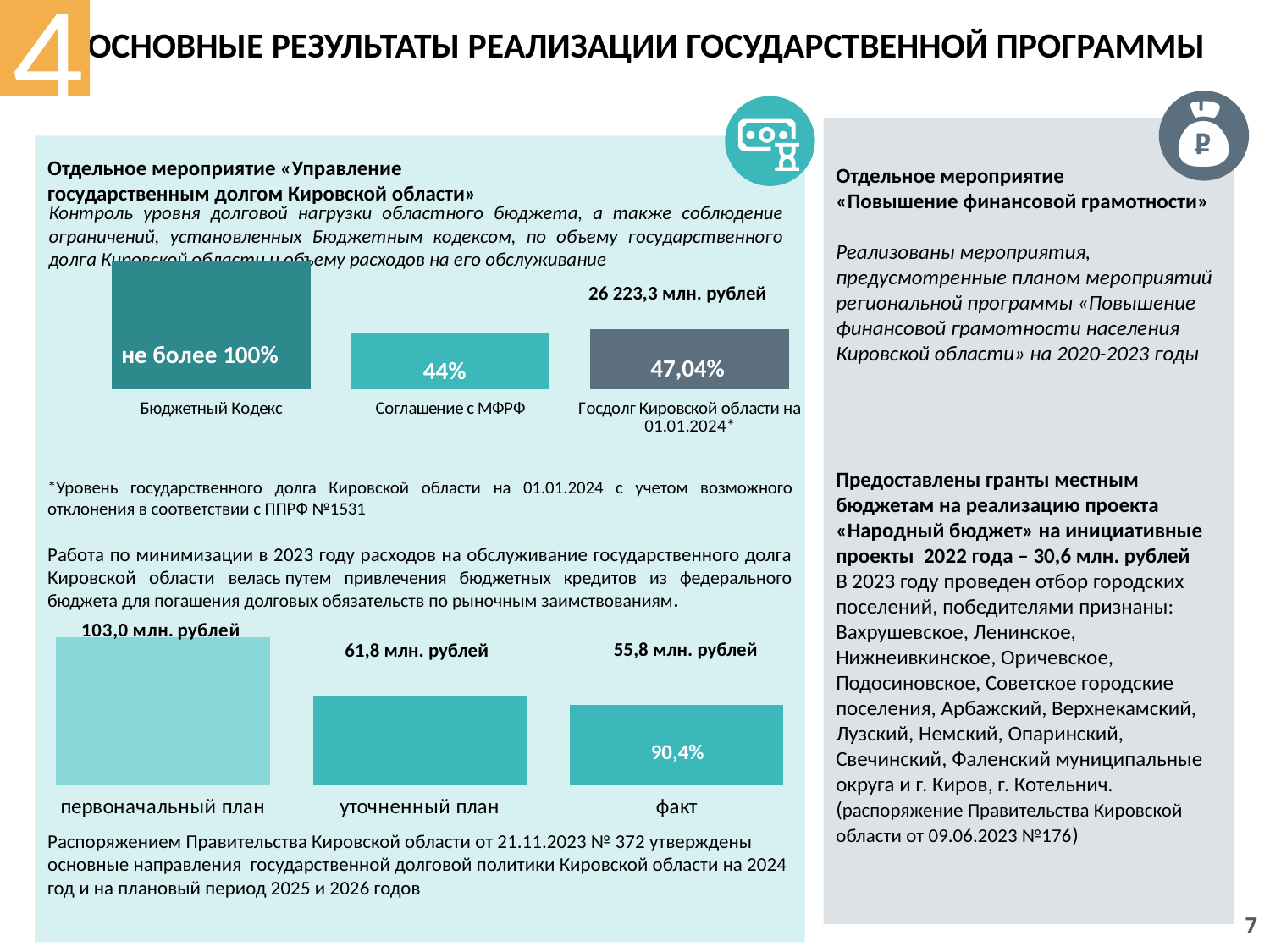
In the lower chart on the left, what percentage is printed inside the «факт» bar? 90,4% In the lower chart on the left, what value is shown for «первоначальный план»? 103,0 млн. рублей In the lower chart on the left, which category has the highest value? первоначальный план In the upper chart on the left, what amount in million rubles is printed above the «Госдолг Кировской области на 01.01.2024*» bar? 26 223,3 млн. рублей In the upper chart on the left, what value is shown for «Соглашение с МФРФ»? 44% In the upper chart on the left, what percentage is shown for «Госдолг Кировской области на 01.01.2024*»? 47,04% In the upper chart on the left, what value is shown for «Бюджетный Кодекс»? не более 100% In the upper chart on the left, which is larger: «Соглашение с МФРФ» or «Госдолг Кировской области на 01.01.2024*»? Госдолг Кировской области на 01.01.2024* In the upper chart on the left, how many bars are there? 3 In the lower chart on the left, what is the difference between «уточненный план» and «факт»? 6,0 млн. рублей In the lower chart on the left, what value is shown for «факт»? 55,8 млн. рублей In the lower chart on the left, what value is shown for «уточненный план»? 61,8 млн. рублей